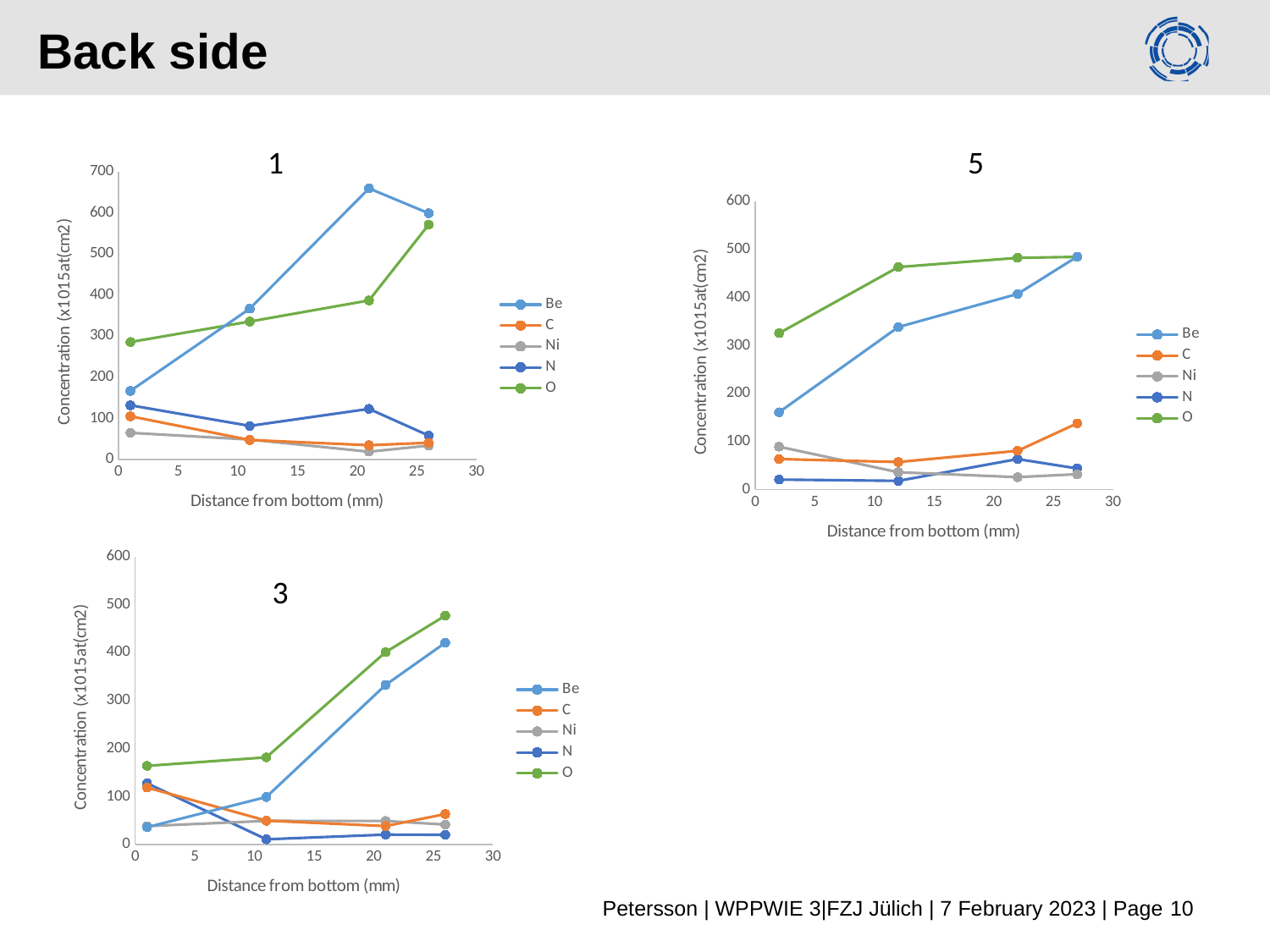
In the chart titled "3", which series has the highest value at 26 mm? O What is the x-axis label of the chart titled "3"? Distance from bottom (mm) In the chart titled "5", does the Be series rise or fall as distance from bottom increases? rise In the chart titled "1", is the Be value at 21 mm greater or less than 600? greater In the chart titled "3", is the O value at 26 mm greater or less than 400? greater In the chart titled "1", which series has the highest value at 21 mm? Be In the chart titled "5", which series has the lowest value at 2 mm? N In the chart titled "5", which is larger at 2 mm, the O value or the Be value? O What kind of chart is the chart titled "1"? line chart In the chart titled "1", how many series does the legend list? 5 In the chart titled "1", how many data points does the Be series have? 4 In the chart titled "5", is the O value at 12 mm greater or less than 400? greater